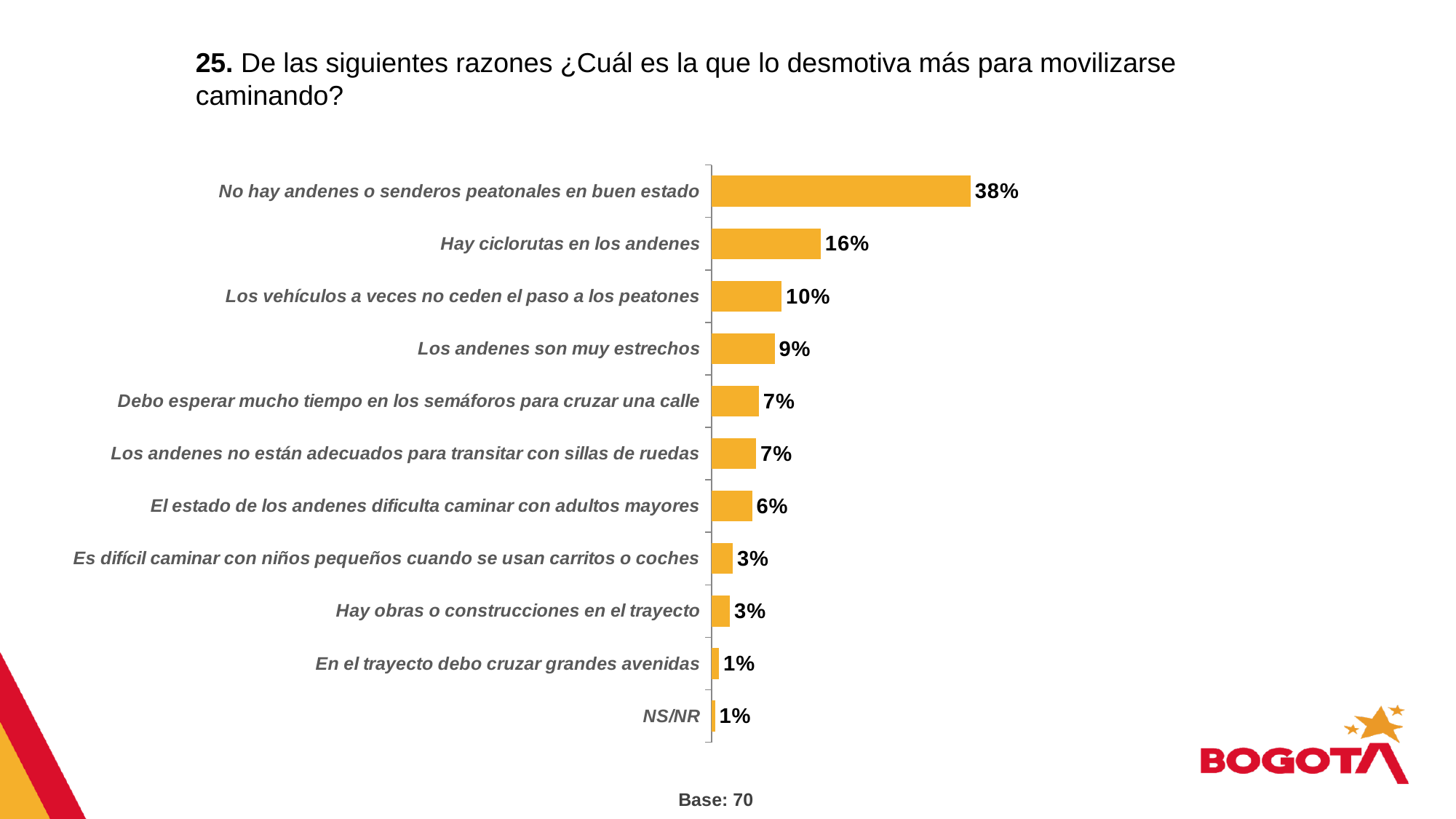
What is the base (number of respondents) shown below the chart? 70 Which reason has the highest percentage? No hay andenes o senderos peatonales en buen estado What is the value for "Hay ciclorutas en los andenes"? 16% What is the difference between "No hay andenes o senderos peatonales en buen estado" and "Hay ciclorutas en los andenes"? 22 percentage points What is the difference between "Los vehículos a veces no ceden el paso a los peatones" and "El estado de los andenes dificulta caminar con adultos mayores"? 4 percentage points What colour are the bars in the chart? Orange Which is larger: "Los vehículos a veces no ceden el paso a los peatones" or "Los andenes son muy estrechos"? Los vehículos a veces no ceden el paso a los peatones What kind of chart is shown on the slide? Bar chart What is the value for "Hay obras o construcciones en el trayecto"? 3% How many categories are shown in the chart? 11 What percentage of respondents chose "No hay andenes o senderos peatonales en buen estado"? 38% What is the value for "Los andenes son muy estrechos"? 9%